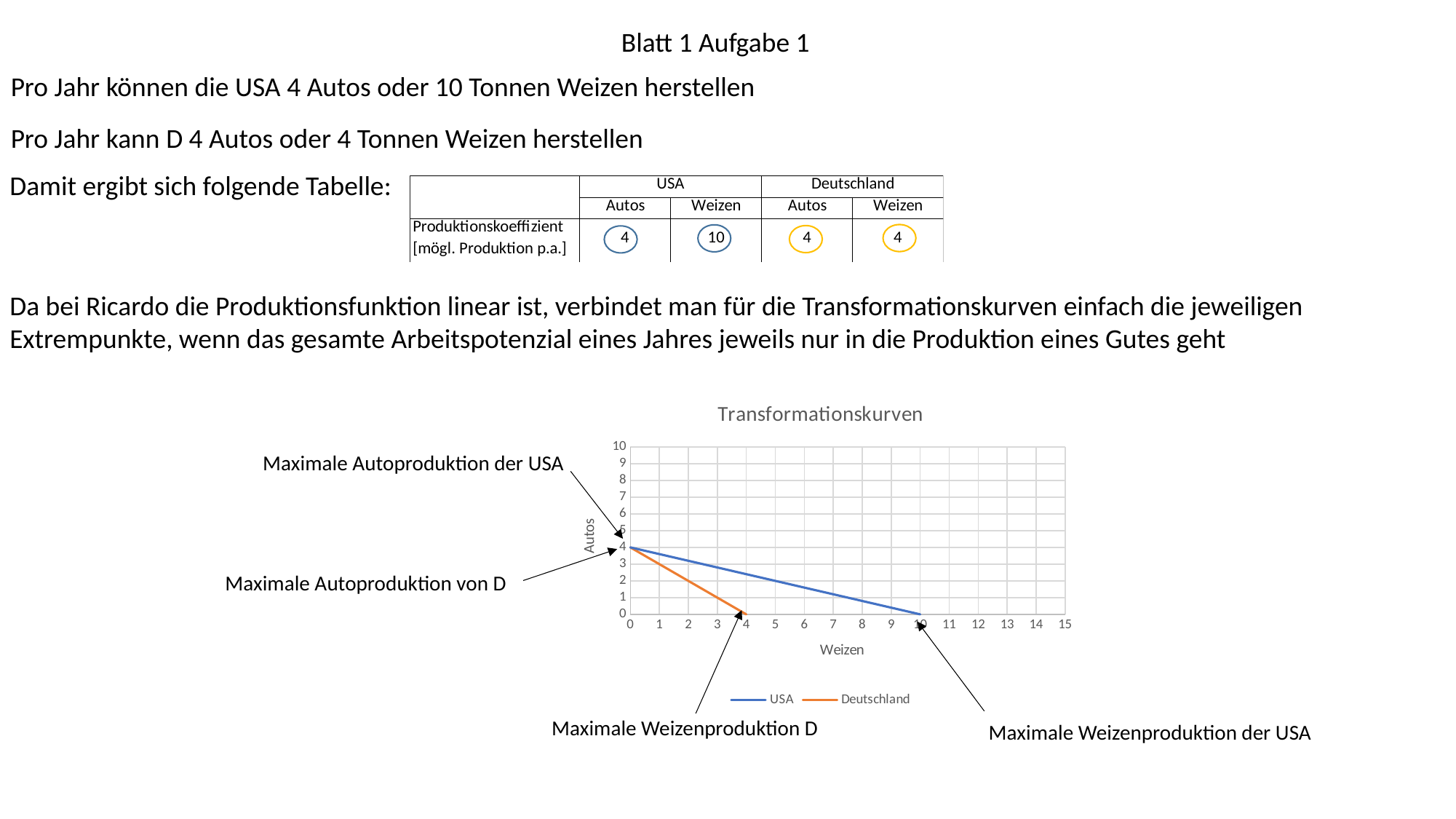
In the Transformationskurven chart, how many Autos does the Deutschland line show at Weizen = 0? 4 In the Transformationskurven chart, what is the difference between the maximum Weizen value of the USA line and that of the Deutschland line? 6 In the Transformationskurven chart, which series reaches the larger maximum Weizen value, USA or Deutschland? USA In the Transformationskurven chart, how many Autos does the USA line show at Weizen = 0? 4 What are the two series named in the legend of the Transformationskurven chart? USA and Deutschland What is the title of the chart on the slide? Transformationskurven In the Transformationskurven chart, at what Weizen value does the USA line reach 0 Autos? 10 In the Transformationskurven chart, is the Autos value of the USA line at Weizen = 5 greater or less than 3? less What kind of chart is shown under the title "Transformationskurven"? line chart How many series does the legend of the Transformationskurven chart list? 2 In the Transformationskurven chart, at what Weizen value does the Deutschland line reach 0 Autos? 4 In the Transformationskurven chart, do the Autos values of the USA line rise or fall as Weizen increases? fall